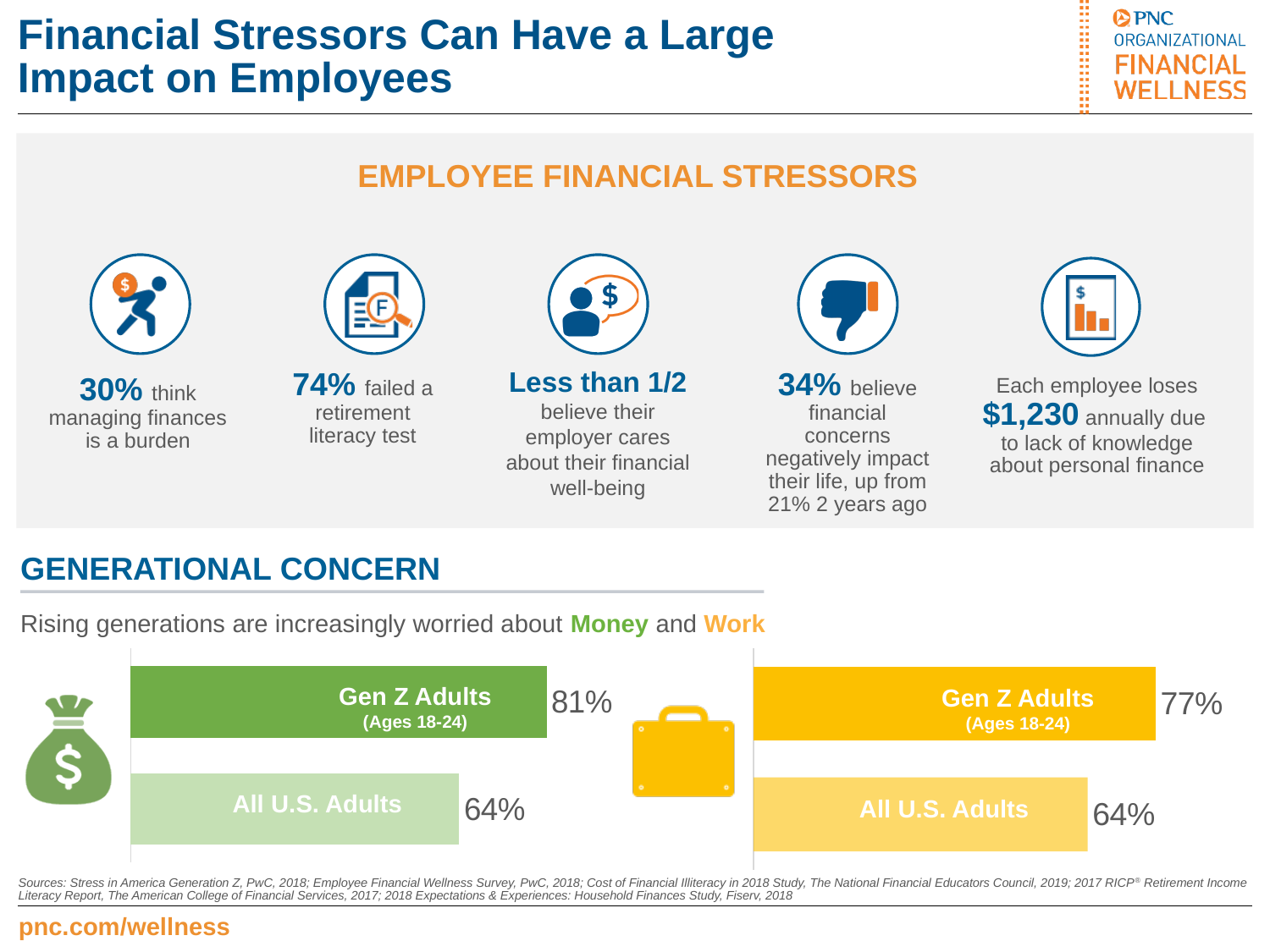
How many bars are in the Work chart? 2 In the Work chart, what percentage is shown for All U.S. Adults? 64% In the Money chart, which group has the higher value? Gen Z Adults (Ages 18-24) Is the Gen Z Adults value larger in the Money chart or the Work chart? Money chart In the Work chart, which group has the lower value? All U.S. Adults In the Work chart, what is the difference between the Gen Z Adults value and the All U.S. Adults value? 13% In the Money chart, what percentage is shown for All U.S. Adults? 64% In the Money chart, what percentage is shown for Gen Z Adults (Ages 18-24)? 81% In the Work chart, what percentage is shown for Gen Z Adults (Ages 18-24)? 77% In the Money chart, what is the difference between the Gen Z Adults value and the All U.S. Adults value? 17% What colour are the bars in the Money chart? Green What type of chart is used in the Generational Concern section? Bar chart